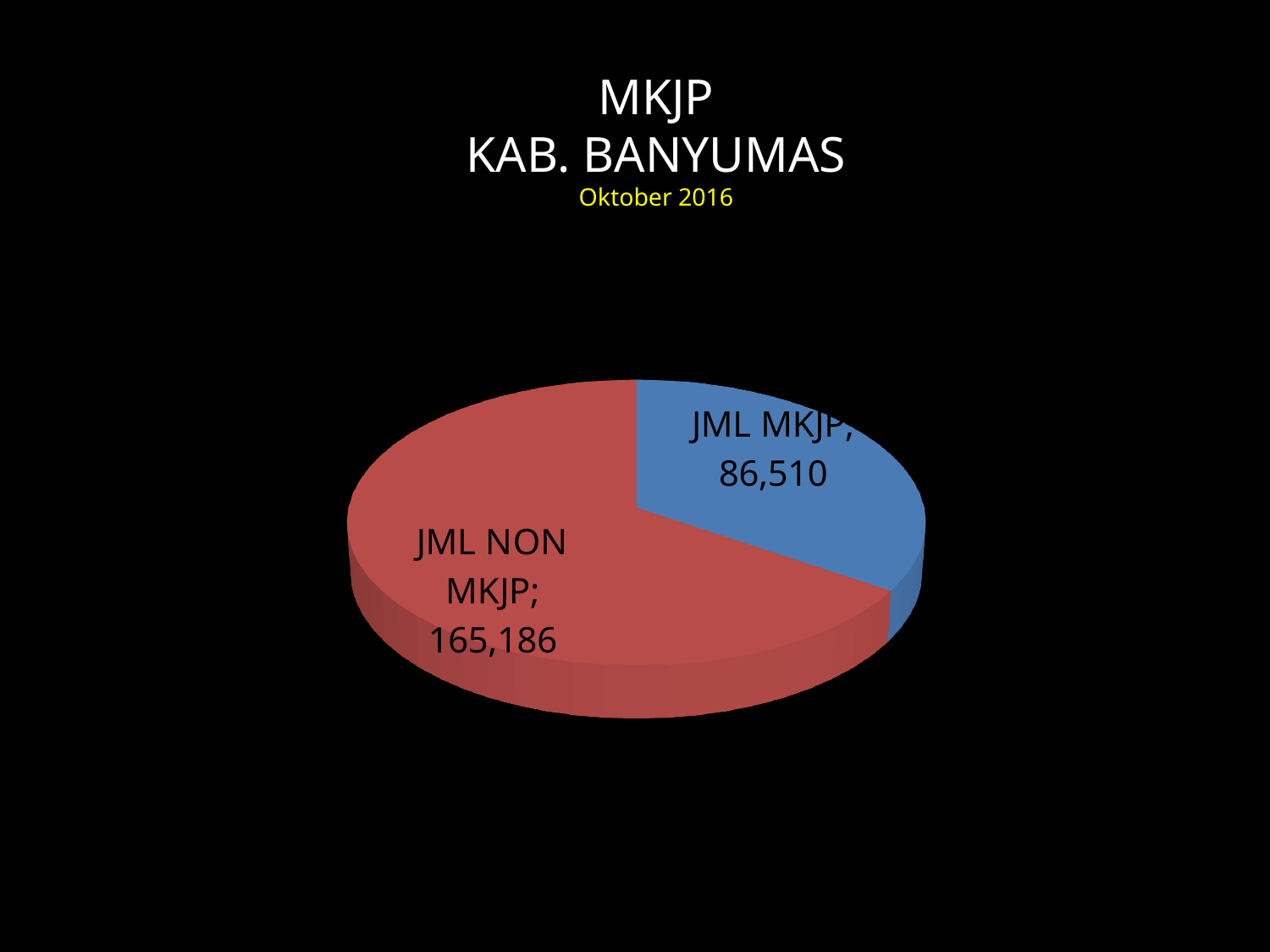
What is the title of the chart? MKJP KAB. BANYUMAS What share of the pie does JML MKJP represent? 34.4% Which is larger, JML MKJP or JML NON MKJP? JML NON MKJP Which slice is the largest? JML NON MKJP What is the value for JML NON MKJP? 165,186 What is the difference between JML NON MKJP and JML MKJP? 78,676 What is the value for JML MKJP? 86,510 Which slice is the smallest? JML MKJP How many slices does the pie chart have? 2 What is the total of the two slices in the pie chart? 251,696 What kind of chart is shown on the slide? pie chart Which month and year does the chart refer to? Oktober 2016